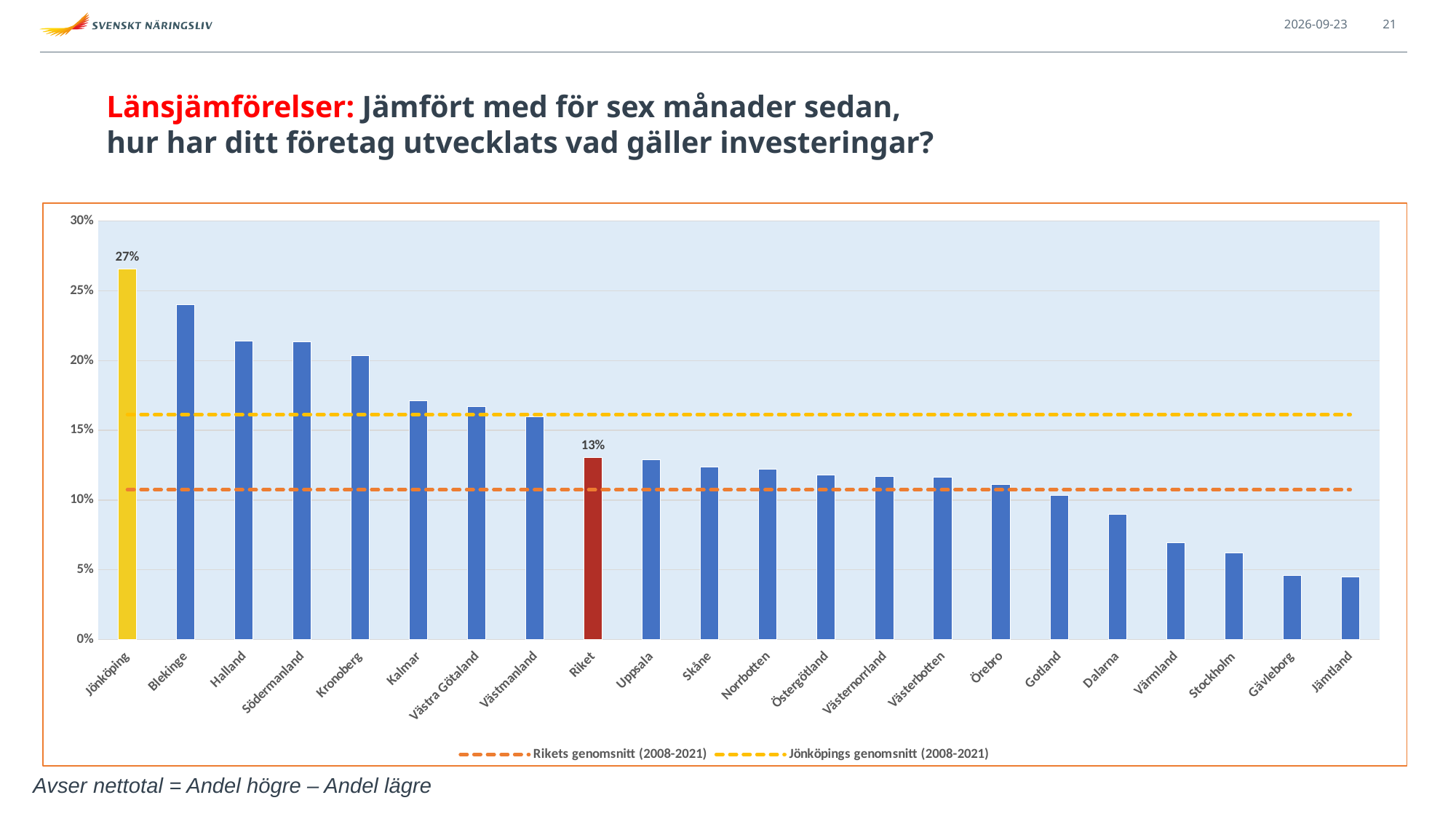
Is the value for Stockholm greater or less than 10%? less What is the difference between the labelled values for Jönköping and Riket? 14 percentage points What kind of chart is shown on the slide? Bar chart How many bars (categories) are shown on the x axis? 22 Which has a higher value, Blekinge or Halland? Blekinge Is the value for Blekinge greater or less than 20%? greater What is the value shown for Riket? 13% What is the value shown for Jönköping? 27% Which county has the highest bar in the chart? Jönköping Do the bar values rise or fall from left to right along the x axis? Fall What colour is the bar for Riket? Red How many entries does the legend list? 2